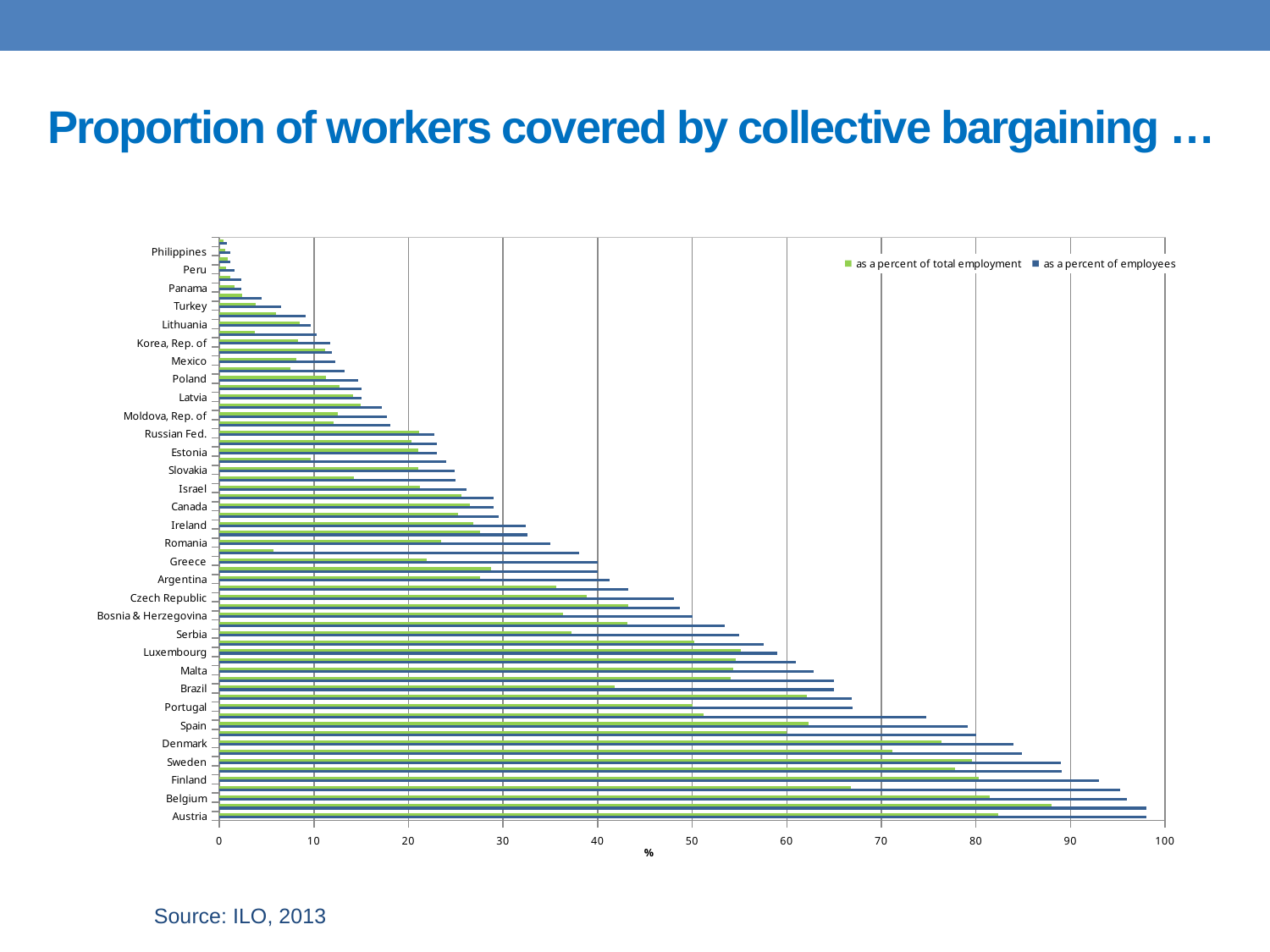
Is the value for Spain as a percent of employees greater or less than 70? greater Which labelled country has the highest value as a percent of employees? Austria What kind of chart is shown on the slide? bar chart Is the value for Austria as a percent of employees greater or less than 90? greater How many series does the legend list? 2 Which has the larger value as a percent of employees, Austria or Philippines? Austria Is the value for Brazil as a percent of total employment greater or less than 50? less Which colour represents the series 'as a percent of employees'? blue For Brazil, which is larger: the value as a percent of total employment or as a percent of employees? as a percent of employees What is the title of the slide's chart? Proportion of workers covered by collective bargaining …